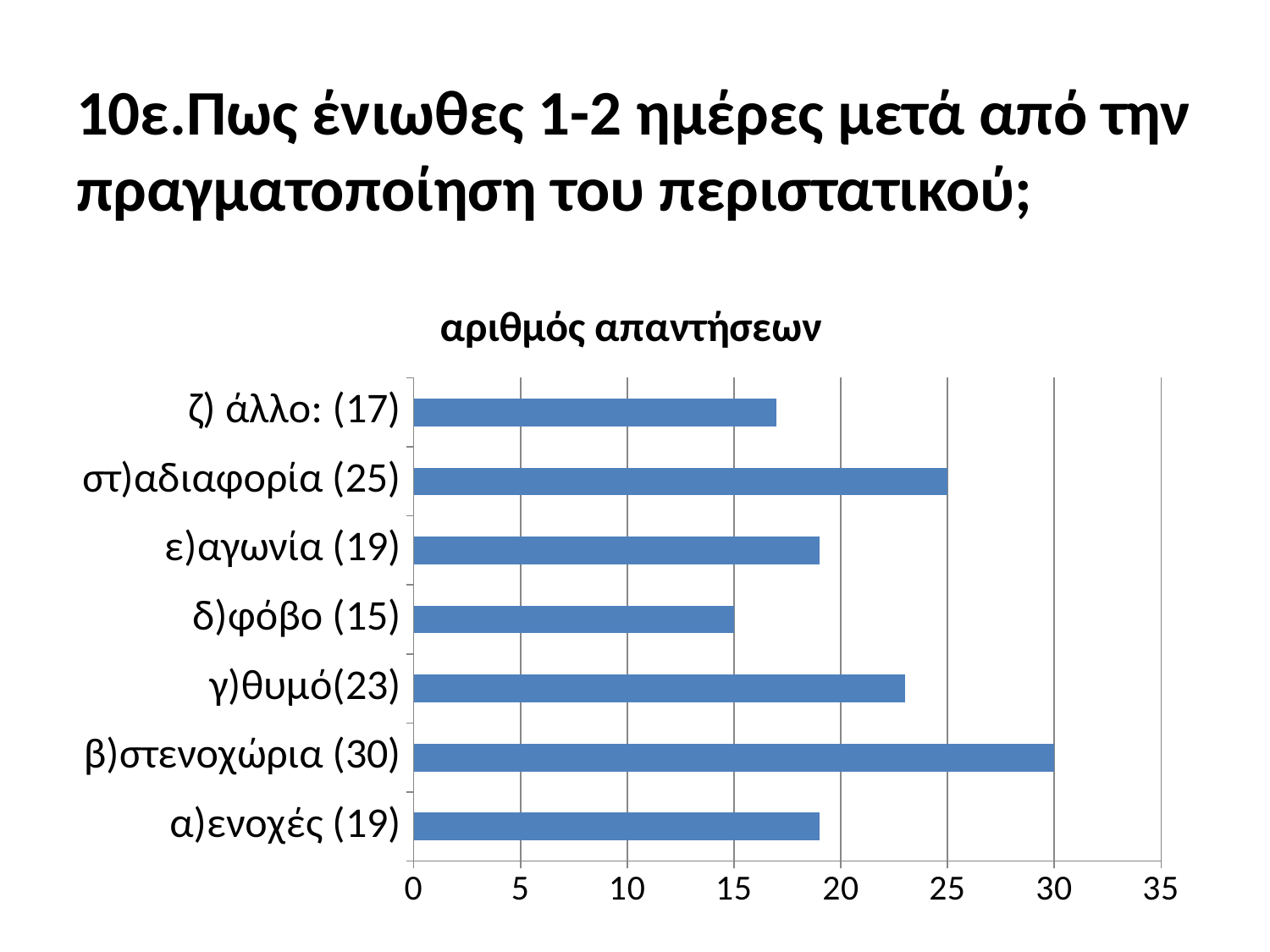
How many categories does the chart show? 7 What is the difference between the values for β)στενοχώρια and δ)φόβο? 15 Which is larger, the value for γ)θυμό or the value for ζ) άλλο? γ)θυμό What is the difference between the values for στ)αδιαφορία and γ)θυμό? 2 What is the value for β)στενοχώρια? 30 Which category has the lowest value? δ)φόβο What kind of chart is shown on the slide? bar chart Is the value for ε)αγωνία greater or less than 20? less What is the title of the chart? αριθμός απαντήσεων Which category has the highest value? β)στενοχώρια What is the value for δ)φόβο? 15 What is the value for στ)αδιαφορία? 25